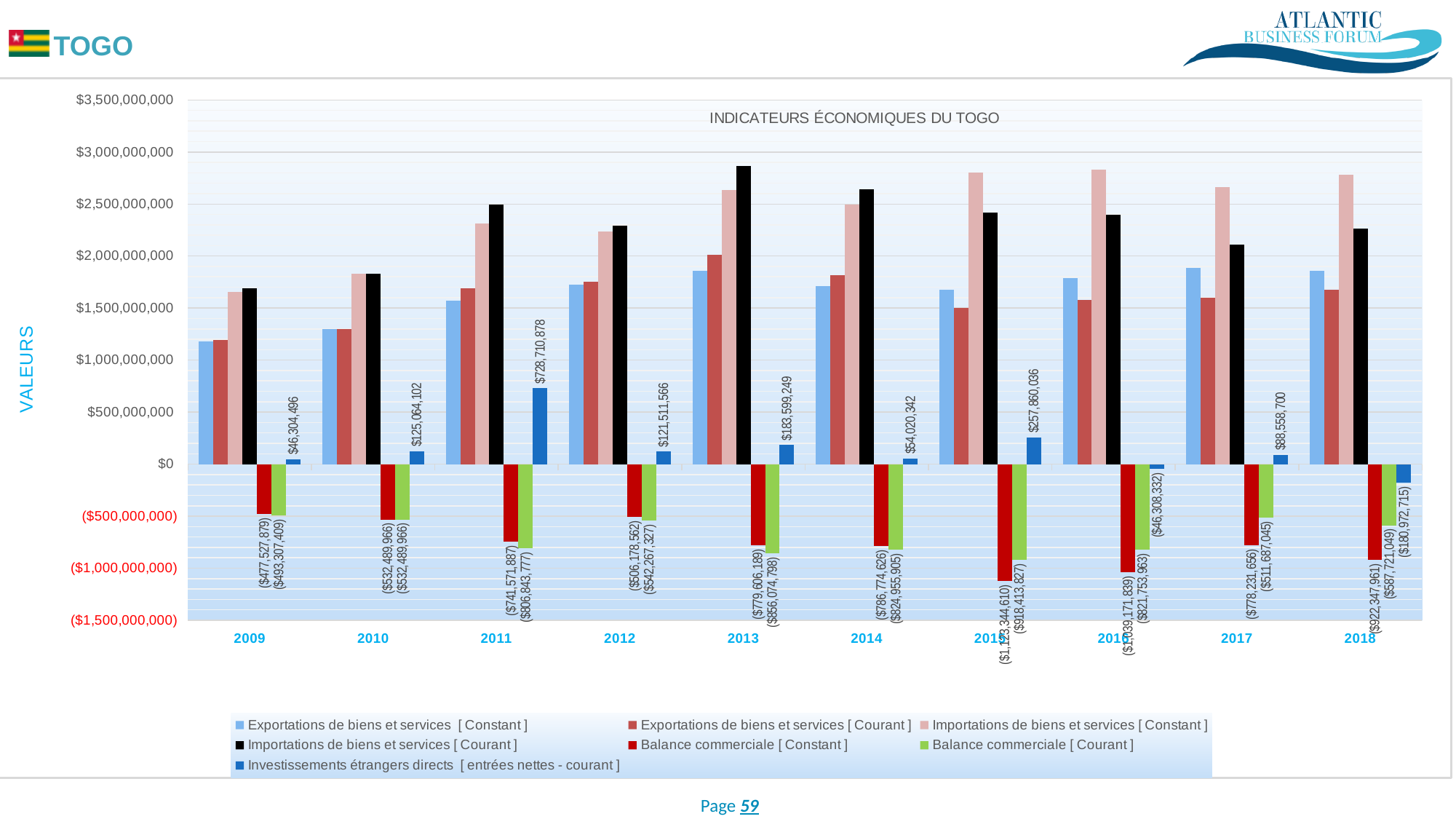
What is the difference between Investissements étrangers directs in 2011 and in 2010? $603,646,776 What is the value of Balance commerciale [Constant] for 2015? ($1,123,344,610) In which year is Investissements étrangers directs [entrées nettes - courant] highest? 2011 How many years are shown on the x axis? 10 What is the value of Investissements étrangers directs [entrées nettes - courant] for 2011? $728,710,878 Is the value for Exportations de biens et services [Constant] in 2009 greater or less than $1,500,000,000? less What is the value of Balance commerciale [Courant] for 2017? ($511,687,045) In which year is Investissements étrangers directs [entrées nettes - courant] lowest? 2018 How many series does the legend list? 7 Is the value for Importations de biens et services [Courant] in 2013 greater or less than $2,500,000,000? greater Which is larger: Exportations de biens et services [Constant] in 2009 or in 2018? 2018 What is the title of the chart? INDICATEURS ÉCONOMIQUES DU TOGO